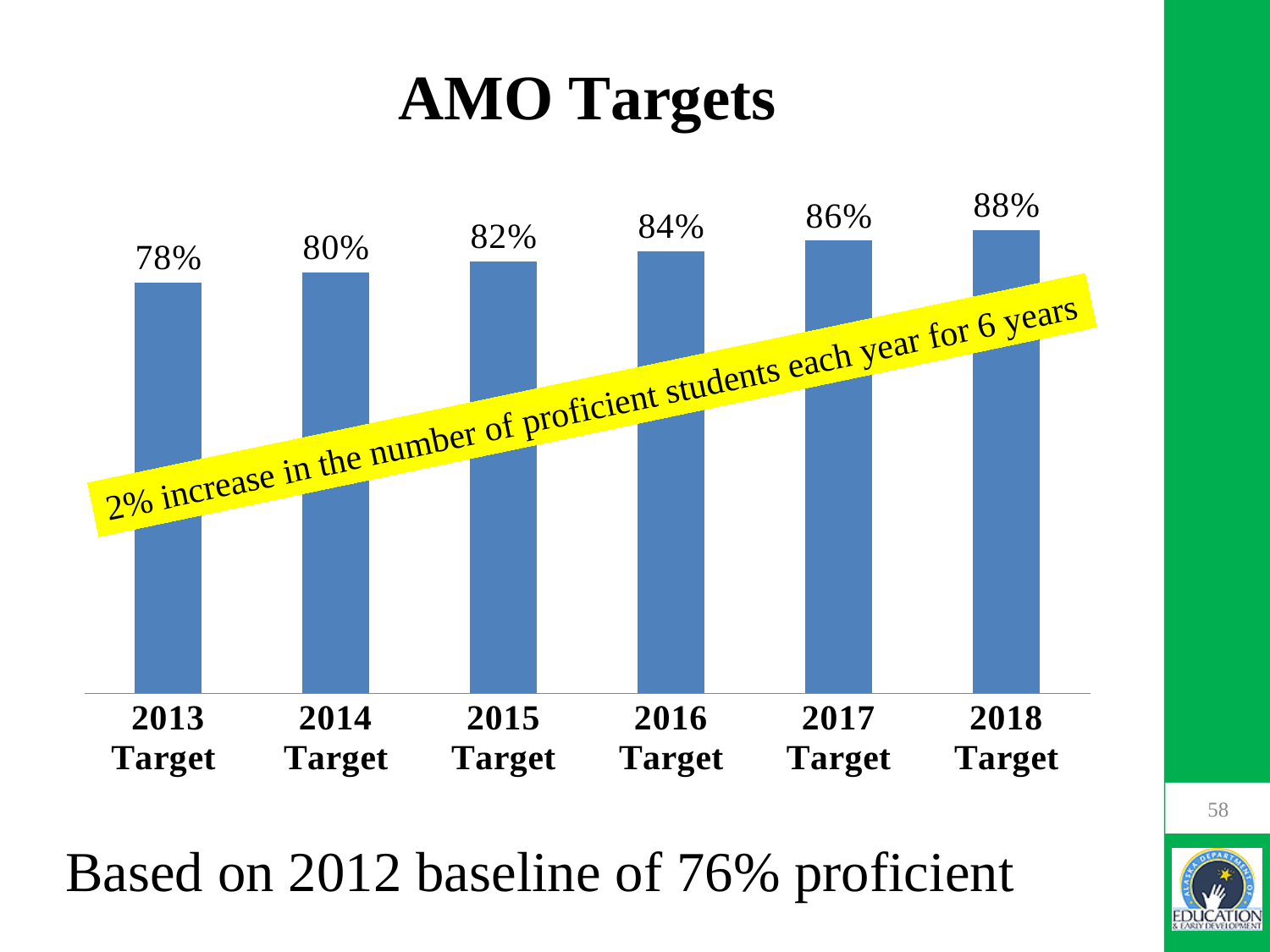
What is the difference between the 2015 Target and the 2014 Target? 2% Do the target values rise or fall from 2013 to 2018? Rise What is the title of the chart? AMO Targets How many target years are shown in the chart? 6 What is the value for the 2018 Target? 88% What is the difference between the 2018 Target and the 2013 Target? 10% Which target year has the lowest value? 2013 Target Which target year has the highest value? 2018 Target What is the value for the 2013 Target? 78% Which is larger, the 2017 Target or the 2015 Target? 2017 Target What is the value for the 2016 Target? 84% What kind of chart is shown on the slide? Bar chart